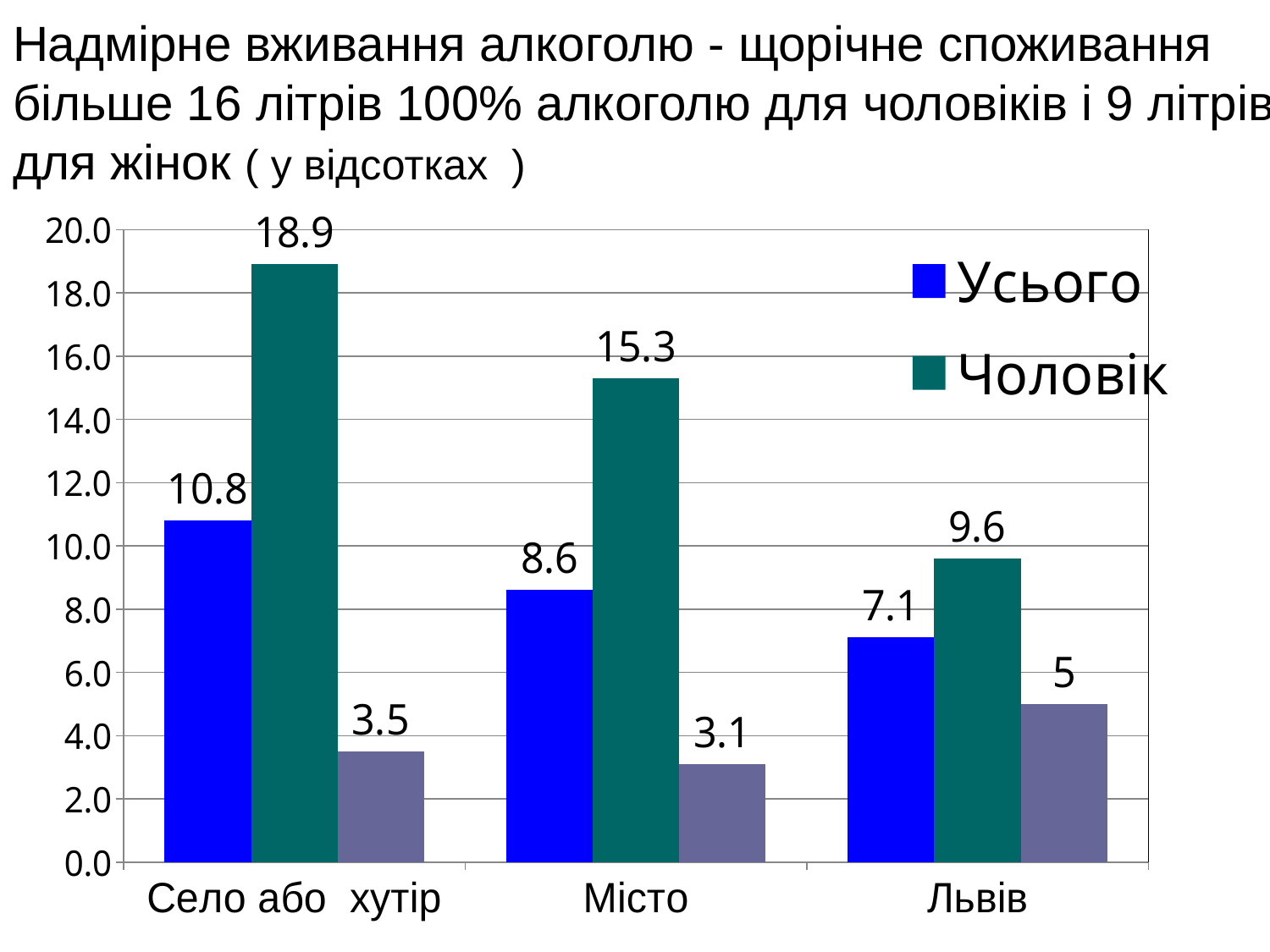
How many series does the legend list? 2 Do the Чоловік values rise or fall from Село або хутір to Львів? fall What is the value of Чоловік for Місто? 15.3 What is the value of Чоловік for Львів? 9.6 What is the value of Усього for Львів? 7.1 What kind of chart is shown on the slide? bar chart What is the difference between the Чоловік value and the Усього value for Село або хутір? 8.1 Which category has the lowest Усього value? Львів Which category has the highest Чоловік value? Село або хутір Which is larger: the Усього value for Місто or the Усього value for Львів? Місто How many categories are shown on the x axis? 3 What is the value of Усього for Село або хутір? 10.8